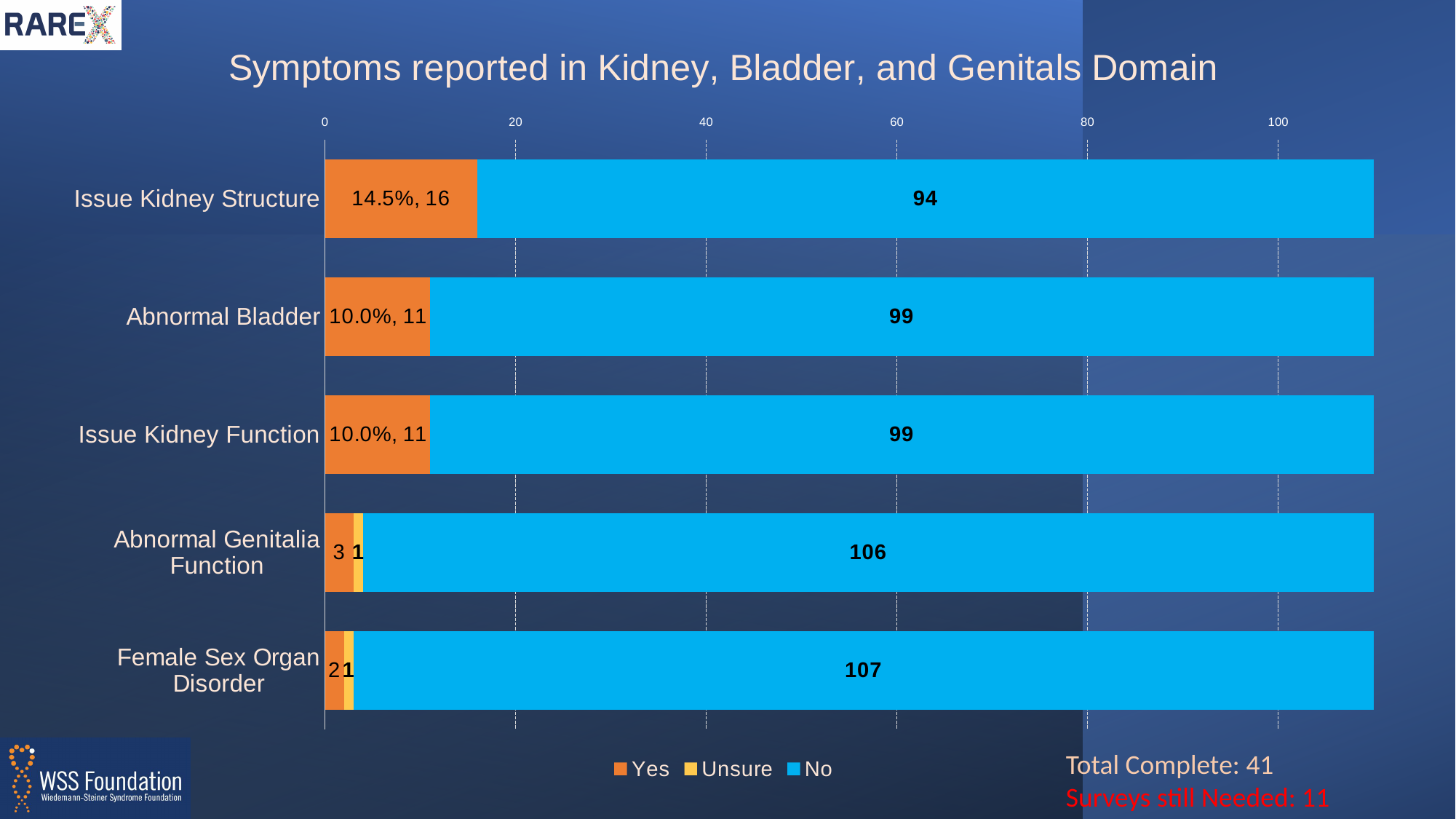
What is the 'No' value for Issue Kidney Structure? 94 Which category has the highest 'Yes' value? Issue Kidney Structure What is the 'Yes' value for Abnormal Bladder? 11 What is the 'No' value for Female Sex Organ Disorder? 107 What is the total of the stacked bar for Abnormal Genitalia Function? 110 Which is larger, the 'Yes' value for Abnormal Genitalia Function or the 'Yes' value for Female Sex Organ Disorder? Abnormal Genitalia Function What is the 'Unsure' value for Abnormal Genitalia Function? 1 What kind of chart is shown on the slide? Stacked bar chart What is the difference between the 'No' values for Female Sex Organ Disorder and Issue Kidney Structure? 13 How many symptom categories are plotted on the chart? 5 Which category has the lowest 'No' value? Issue Kidney Structure How many series does the legend list? 3